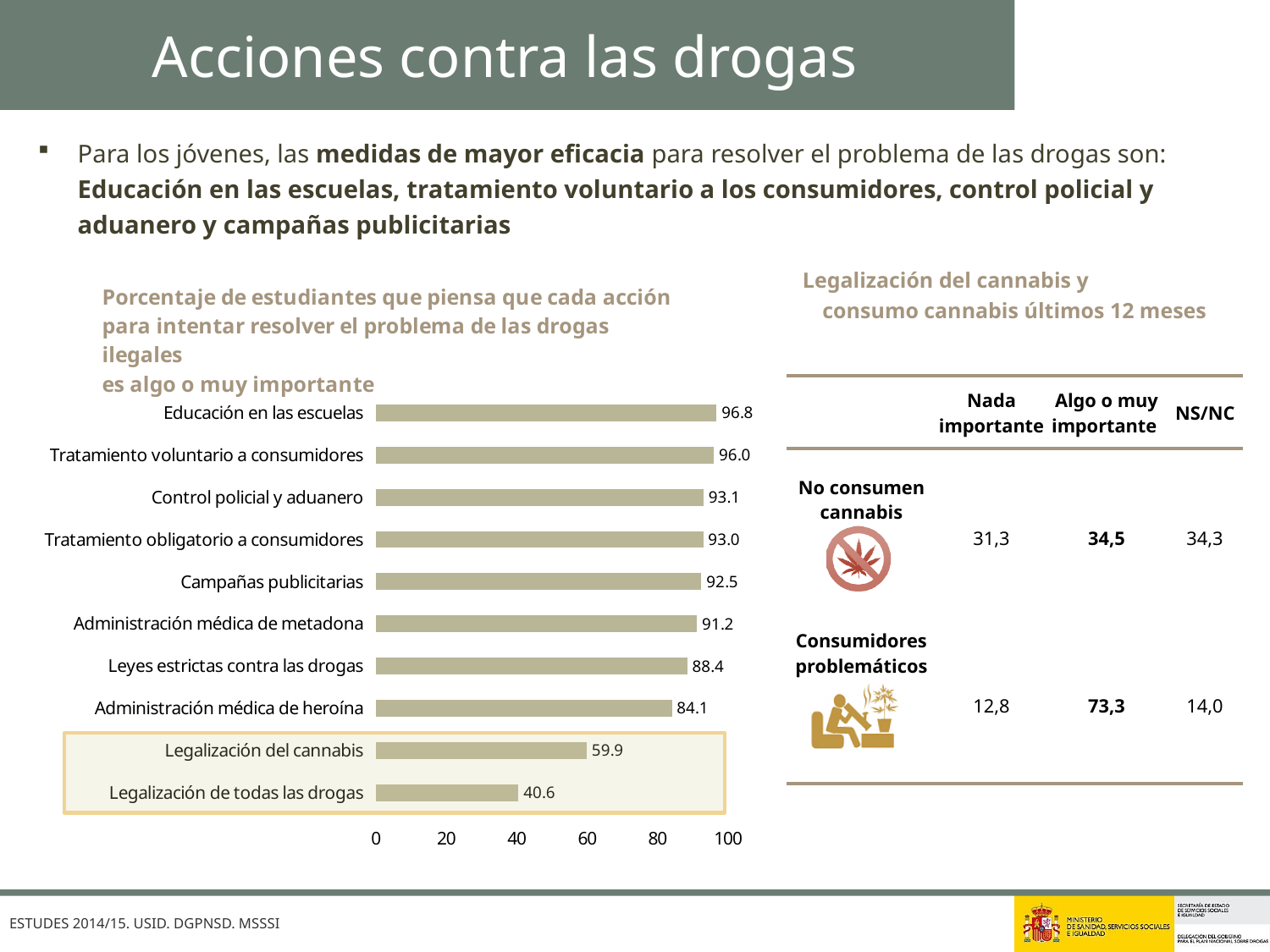
What is the value shown for 'Administración médica de heroína'? 84.1 What is the difference between the values for 'Educación en las escuelas' and 'Tratamiento voluntario a consumidores'? 0.8 Which has a larger value: 'Leyes estrictas contra las drogas' or 'Administración médica de metadona'? Administración médica de metadona What type of chart is used to show the percentage of students who think each action is important? Bar chart What is the value shown for 'Legalización del cannabis'? 59.9 What percentage of students consider 'Educación en las escuelas' somewhat or very important? 96.8 How many actions (categories) are shown in the bar chart? 10 Which action has the highest percentage in the bar chart? Educación en las escuelas Which action has the lowest percentage in the bar chart? Legalización de todas las drogas What is the maximum value shown on the horizontal axis of the bar chart? 100 What is the difference between the values for 'Legalización del cannabis' and 'Legalización de todas las drogas'? 19.3 Is the value for 'Legalización de todas las drogas' greater or less than 60? less